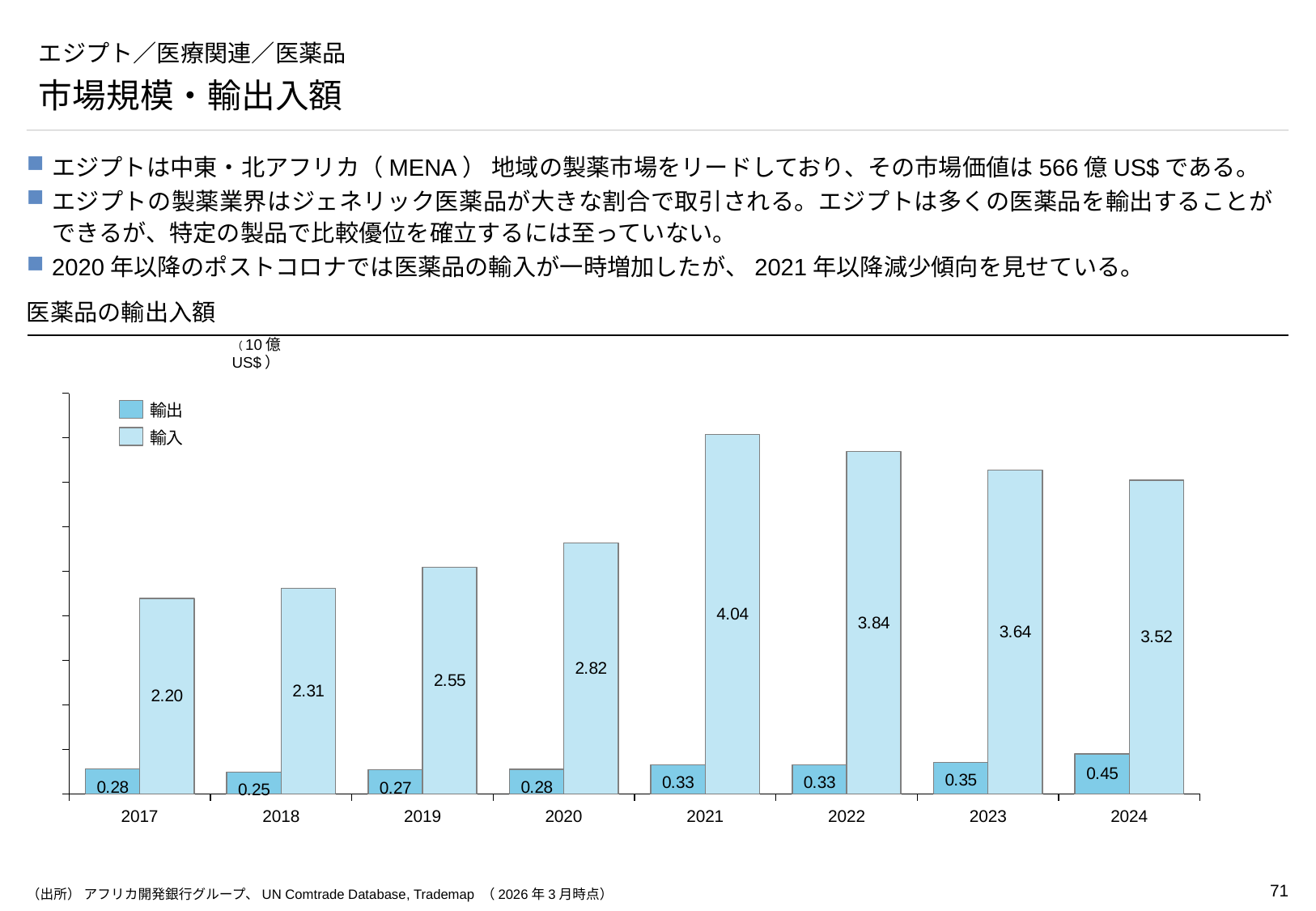
Which year has the highest 輸入 value? 2021 Do the 輸入 values rise or fall from 2021 to 2024? fall How many series does the legend list? 2 How many years are shown on the x axis? 8 What is the value of 輸入 for 2021? 4.04 What is the value of 輸出 for 2024? 0.45 What kind of chart is shown? bar chart Which year has the lowest 輸出 value? 2018 Which is larger, the 輸入 value for 2019 or for 2020? 2020 What unit is shown for the chart values? 10億US$ What is the difference between the 輸入 values for 2021 and 2024? 0.52 What is the value of 輸入 for 2017? 2.20